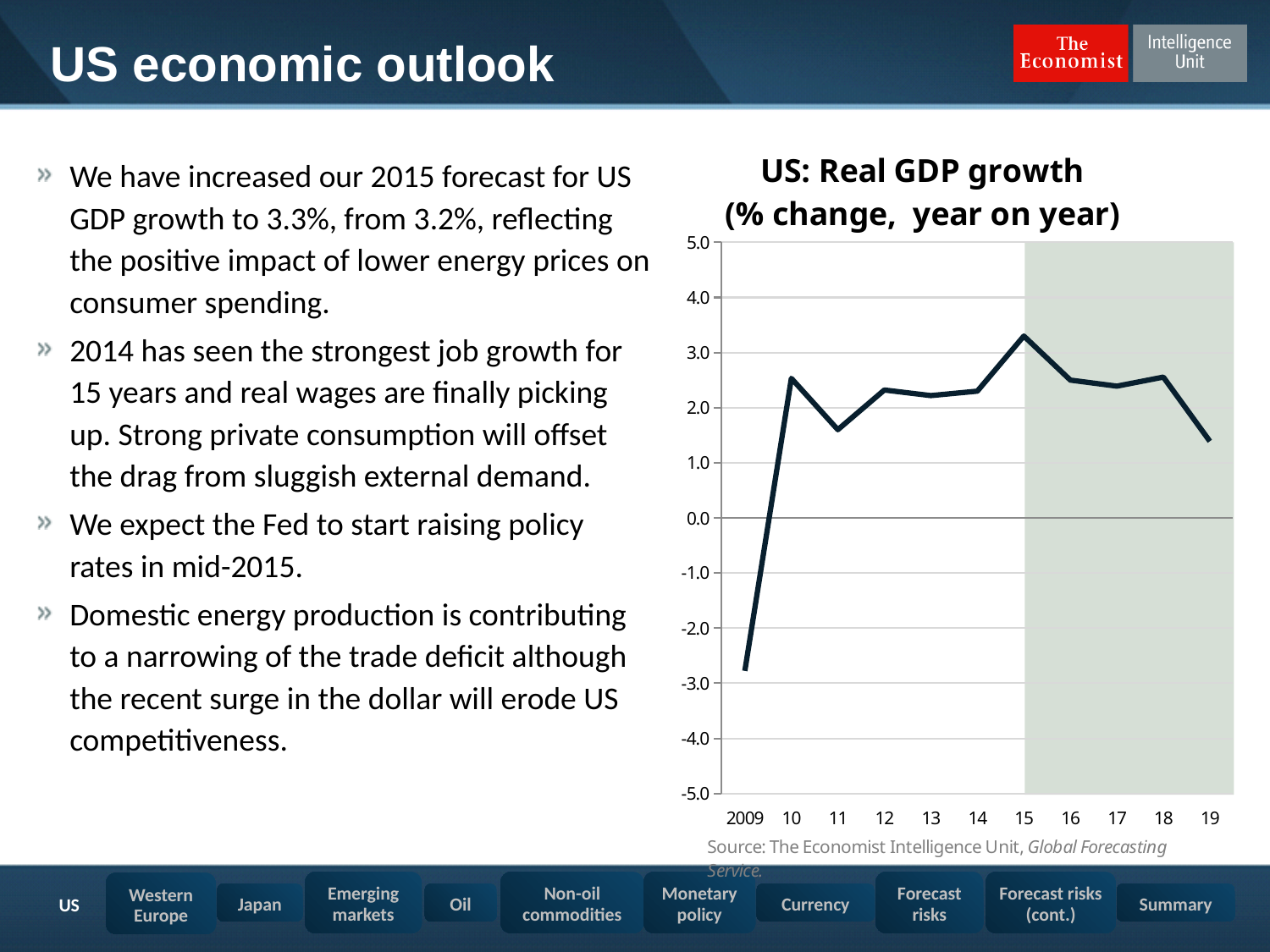
Is the value for 2011 greater or less than 2.0? less Which year has the highest real GDP growth in the chart? 2015 Is the value for 2019 greater or less than 2.0? less Is the value for 2015 greater or less than 3.0? greater What kind of chart is shown on the slide? line chart Which year has the larger real GDP growth, 2015 or 2019? 2015 Does real GDP growth rise or fall from 2015 to 2019? fall What is the source cited below the chart? The Economist Intelligence Unit, Global Forecasting Service Which year has the lowest real GDP growth in the chart? 2009 What is the title of the chart? US: Real GDP growth (% change, year on year) How many years are plotted on the x axis of the chart? 11